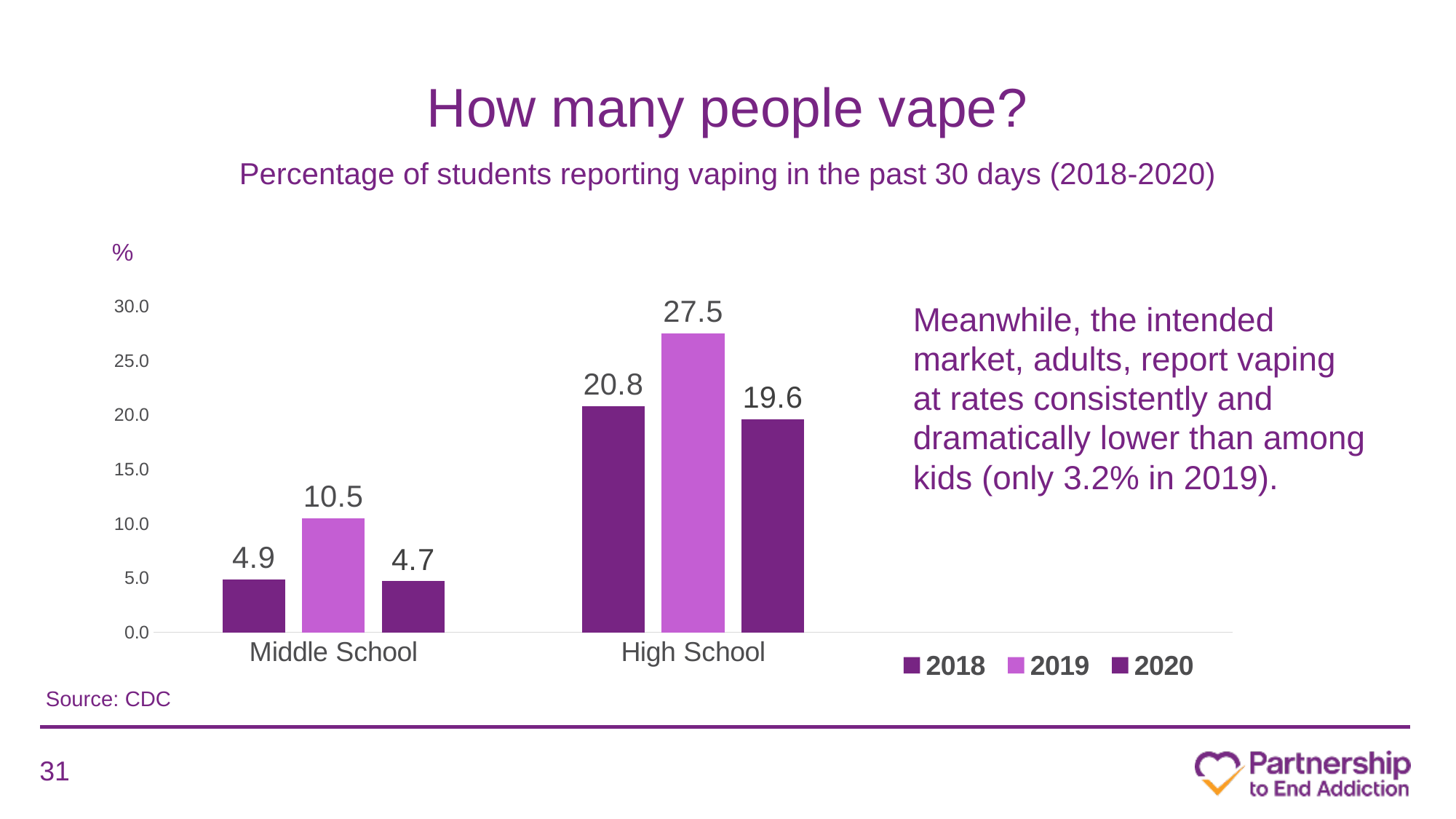
What percentage of high school students reported vaping in 2020? 19.6 What is the difference between the 2019 and 2020 values for high school students? 7.9 What is the source cited for the chart? CDC How many categories are shown on the x axis? 2 Which year has the lowest value for middle school students? 2020 How many series does the legend list? 3 What is the value for high school students in 2018? 20.8 Which is larger: the 2018 value for middle school or the 2020 value for high school? 2020 value for high school What kind of chart is shown on the slide? Bar chart What is the difference between the 2019 and 2018 values for middle school students? 5.6 Which year has the highest value for high school students? 2019 What percentage of middle school students reported vaping in 2019? 10.5